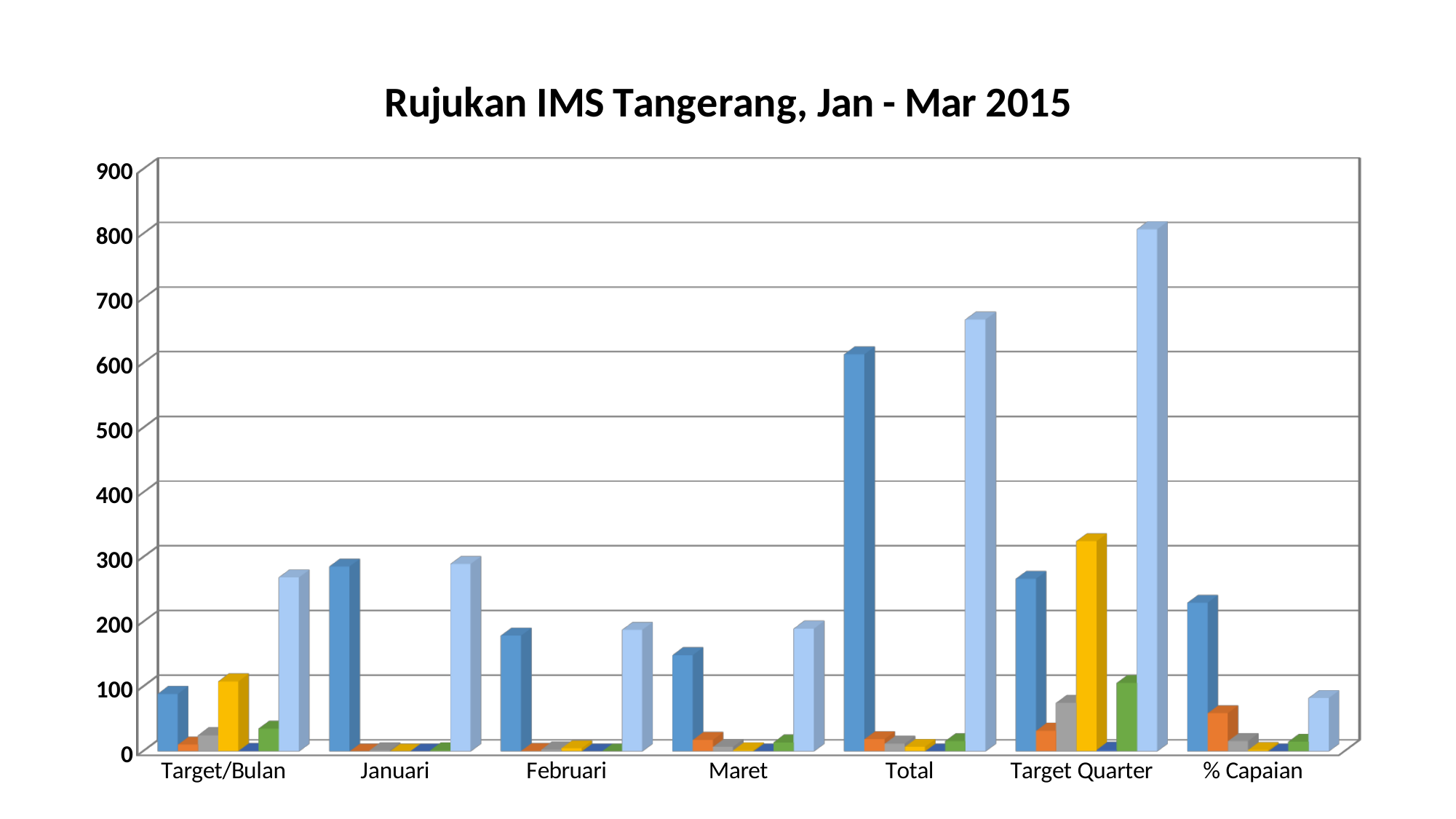
Is the light blue bar for Total greater or less than 600? greater Which is larger: the dark blue bar for Januari or the dark blue bar for Maret? Januari Is the dark blue bar for Februari greater or less than 200? less Do the dark blue bars rise or fall from Januari to Maret? fall Is the light blue bar for Target Quarter greater or less than 700? greater How many categories are shown on the x axis? 7 What is the title of the chart? Rujukan IMS Tangerang, Jan - Mar 2015 What kind of chart is shown on the slide? bar chart Which category contains the tallest bar in the chart? Target Quarter In the Total category, which is larger: the dark blue bar or the light blue bar? the light blue bar